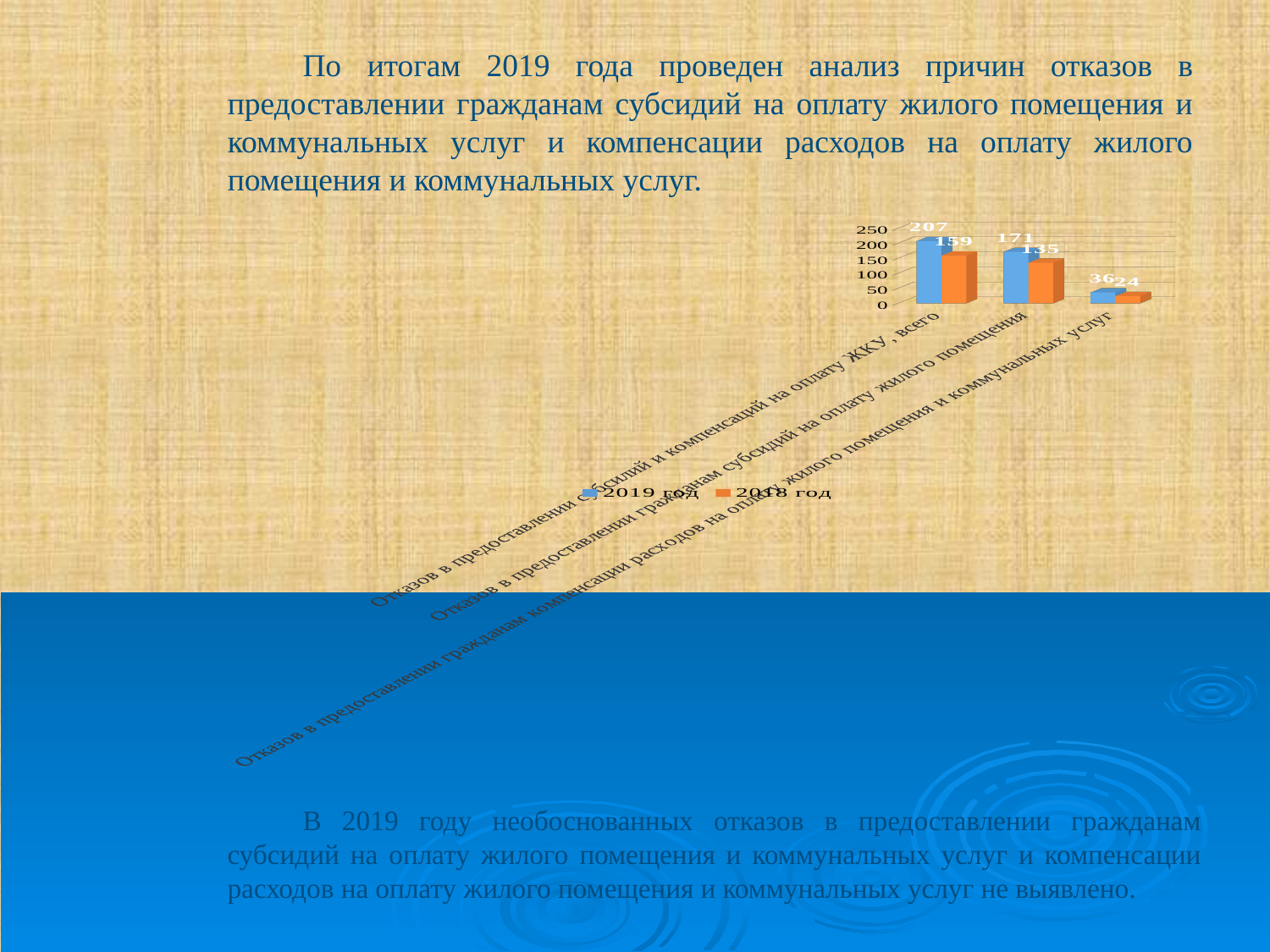
Which category has the lowest value for 2018 год? Отказов в предоставлении гражданам компенсации расходов на оплату жилого помещения и коммунальных услуг What is the value for 2019 год in the category 'Отказов в предоставлении гражданам субсидий на оплату жилого помещения'? 171 What is the value for 2018 год in the category 'Отказов в предоставлении субсидий и компенсаций на оплату ЖКУ, всего'? 159 What is the value for 2018 год in the category 'Отказов в предоставлении гражданам компенсации расходов на оплату жилого помещения и коммунальных услуг'? 24 How many categories are shown on the chart's x axis? 3 Which series is shown in orange in the chart legend? 2018 год In the category 'Отказов в предоставлении гражданам субсидий на оплату жилого помещения', which series has the larger value, 2019 год or 2018 год? 2019 год How many series does the chart legend list? 2 Which category has the highest value for 2019 год? Отказов в предоставлении субсидий и компенсаций на оплату ЖКУ, всего What is the difference between the 2019 год and 2018 год values in the category 'Отказов в предоставлении субсидий и компенсаций на оплату ЖКУ, всего'? 48 What is the value for 2019 год in the category 'Отказов в предоставлении субсидий и компенсаций на оплату ЖКУ, всего'? 207 What type of chart is shown on the slide? bar chart